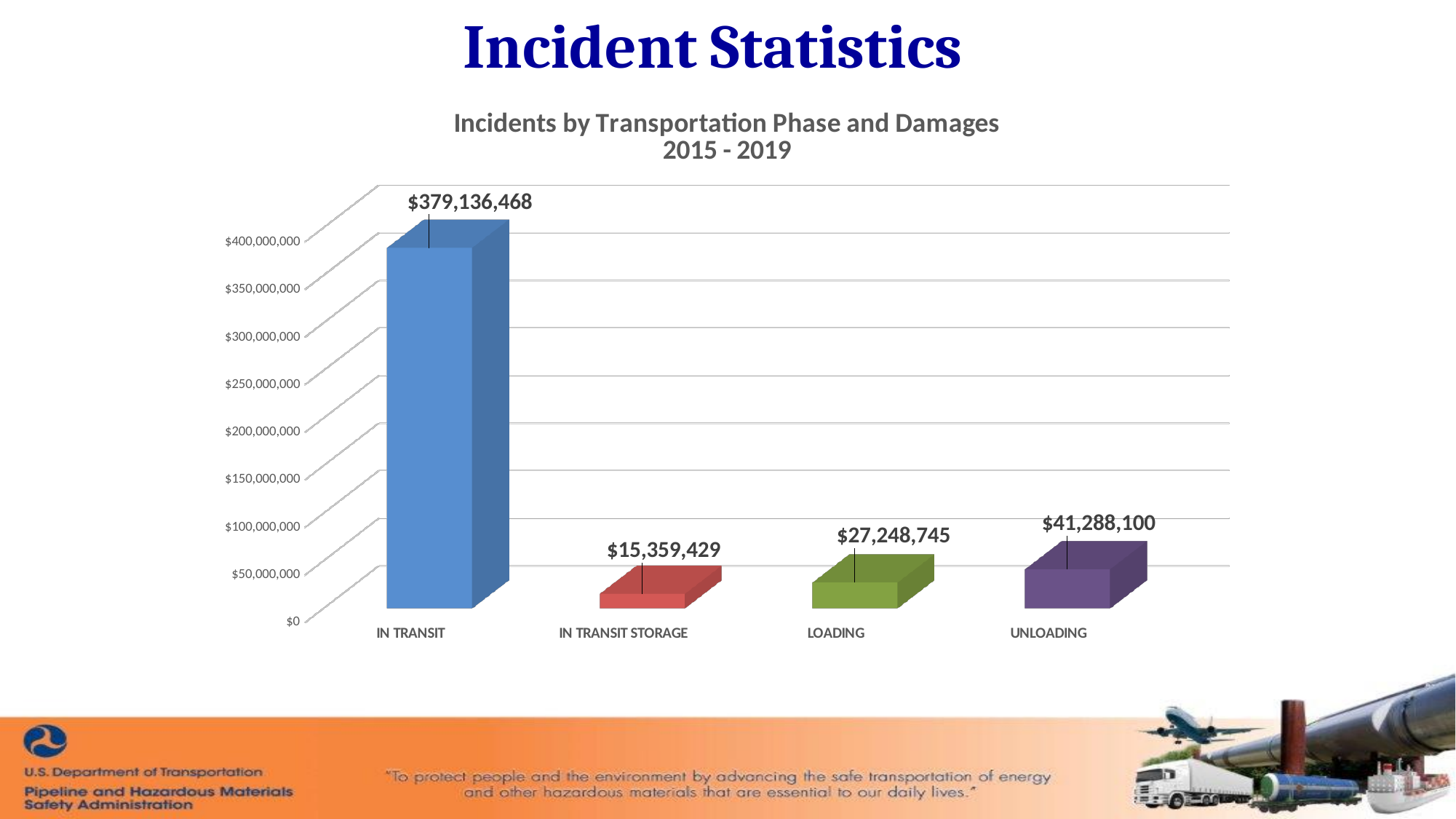
What kind of chart is shown on the slide? Bar chart Which transportation phase has the highest damages? IN TRANSIT What is the damages value for IN TRANSIT? $379,136,468 How many transportation phases are shown on the chart? 4 What is the damages value for LOADING? $27,248,745 Is the value for IN TRANSIT greater or less than $350,000,000? greater What is the difference in damages between IN TRANSIT and IN TRANSIT STORAGE? $363,777,039 What is the damages value for IN TRANSIT STORAGE? $15,359,429 Which transportation phase has the lowest damages? IN TRANSIT STORAGE What is the difference in damages between UNLOADING and LOADING? $14,039,355 Which has larger damages, LOADING or UNLOADING? UNLOADING What is the damages value for UNLOADING? $41,288,100